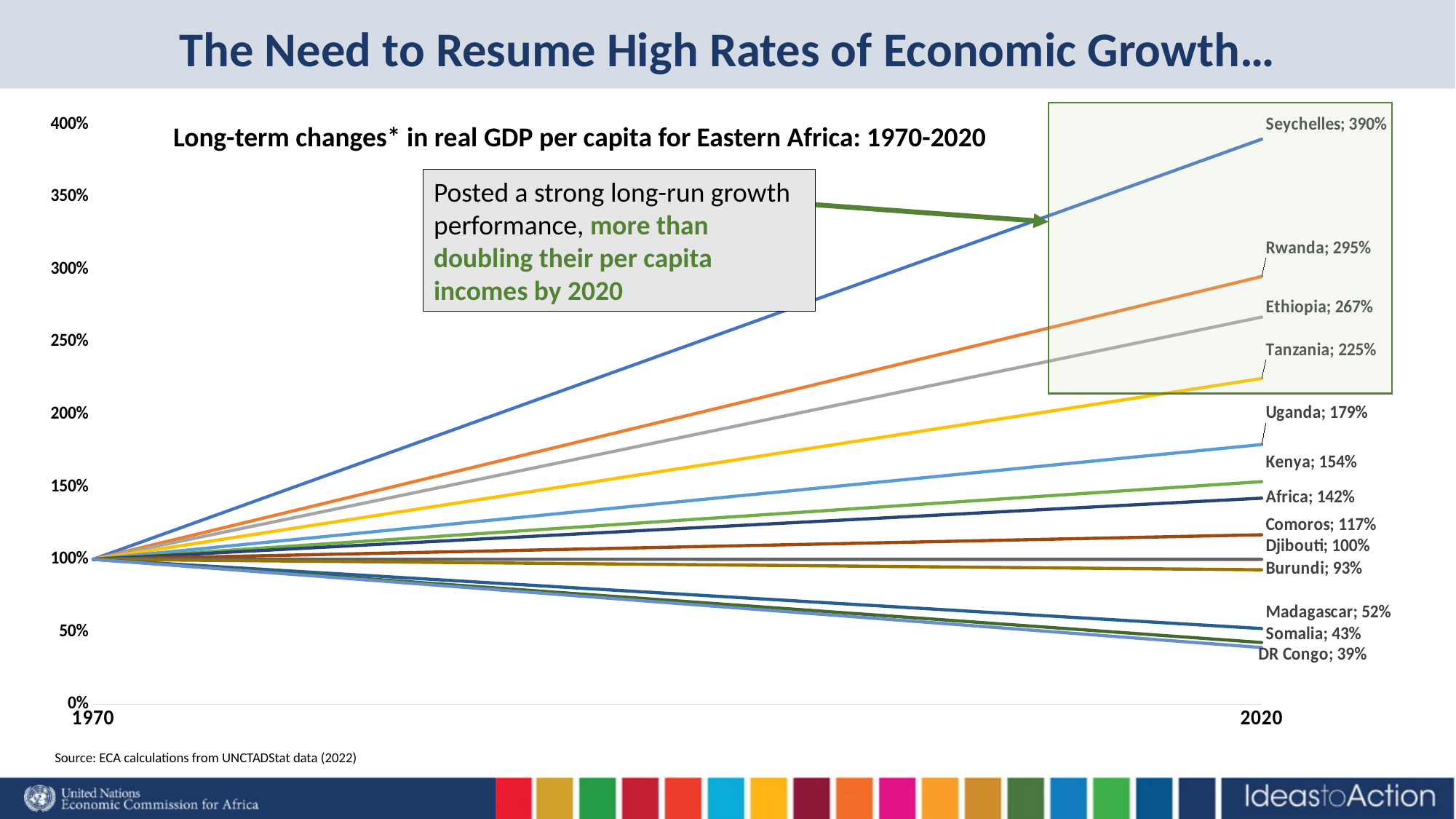
What is the 2020 value for Burundi? 93% What is the 2020 value for Rwanda? 295% Does the line for Madagascar rise or fall from 1970 to 2020? Fall Which country has the lowest 2020 value? DR Congo What kind of chart is shown on the slide? Line chart Which country has the highest 2020 value? Seychelles What is the 2020 value for Seychelles? 390% What is the 2020 value for Tanzania? 225% Which has a higher 2020 value, Ethiopia or Tanzania? Ethiopia What is the difference between the 2020 values for Uganda and Kenya? 25% What is the difference between the 2020 values for Seychelles and Rwanda? 95% How many lines (countries/regions) are plotted on the chart? 13